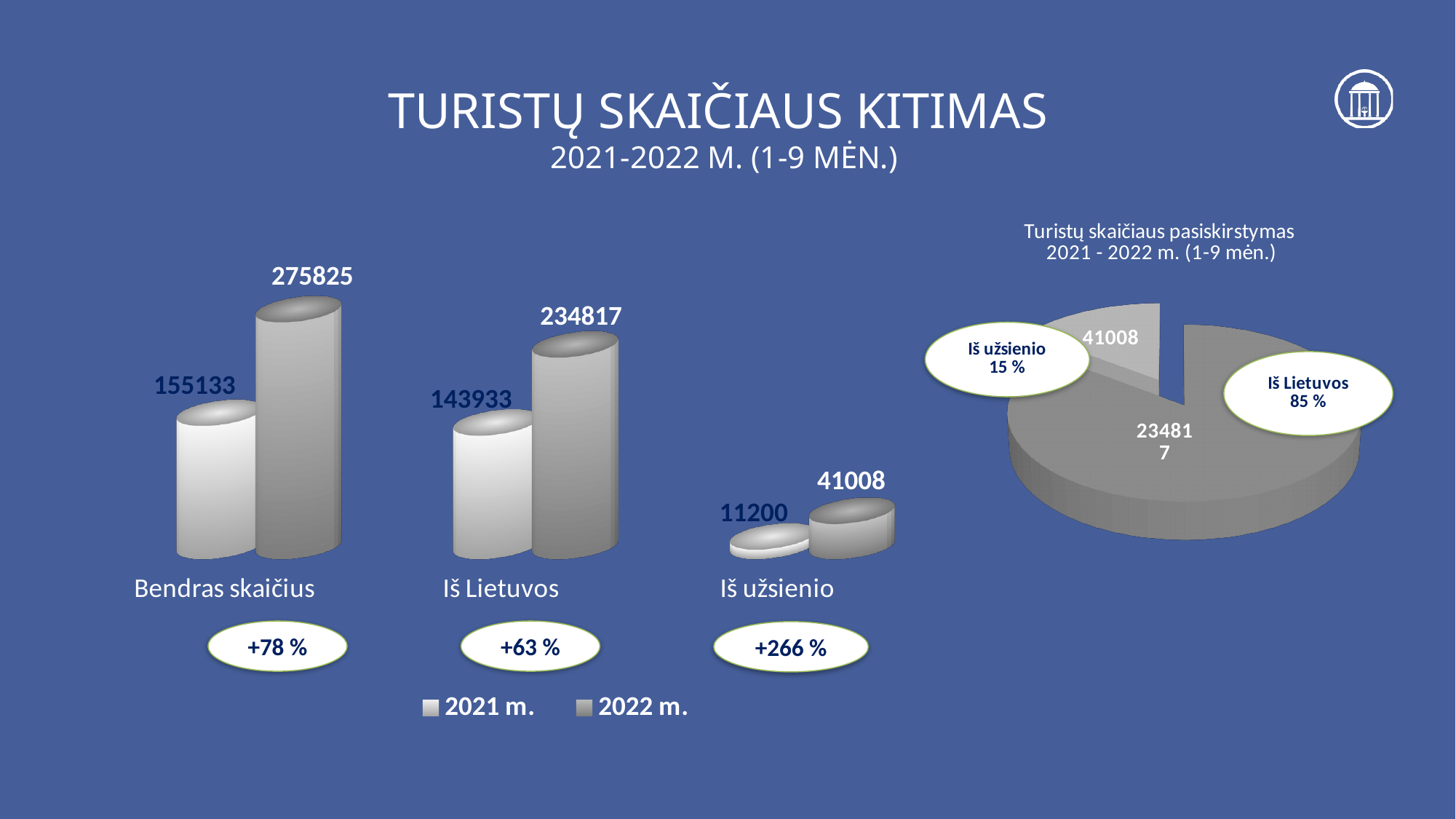
In the left bar chart, which category has the highest value in 2021 m.? Bendras skaičius In the left bar chart, what is the value for Iš Lietuvos in 2021 m.? 143933 How many series does the legend of the left bar chart list? 2 In the left bar chart, which is larger: the 2022 m. value for Iš Lietuvos or the 2021 m. value for Bendras skaičius? 2022 m. value for Iš Lietuvos In the left bar chart, what is the value for Bendras skaičius in 2022 m.? 275825 In the left bar chart, what is the value for Iš užsienio in 2021 m.? 11200 In the left bar chart, what is the difference between the 2022 m. and 2021 m. values for Iš užsienio? 29808 In the left bar chart, which category has the lowest value in 2022 m.? Iš užsienio What kind of chart is the chart on the right titled 'Turistų skaičiaus pasiskirstymas'? Pie chart In the pie chart on the right, what share does Iš užsienio have? 15 % How many categories are shown in the left bar chart? 3 In the left bar chart, what is the difference between the 2022 m. and 2021 m. values for Bendras skaičius? 120692